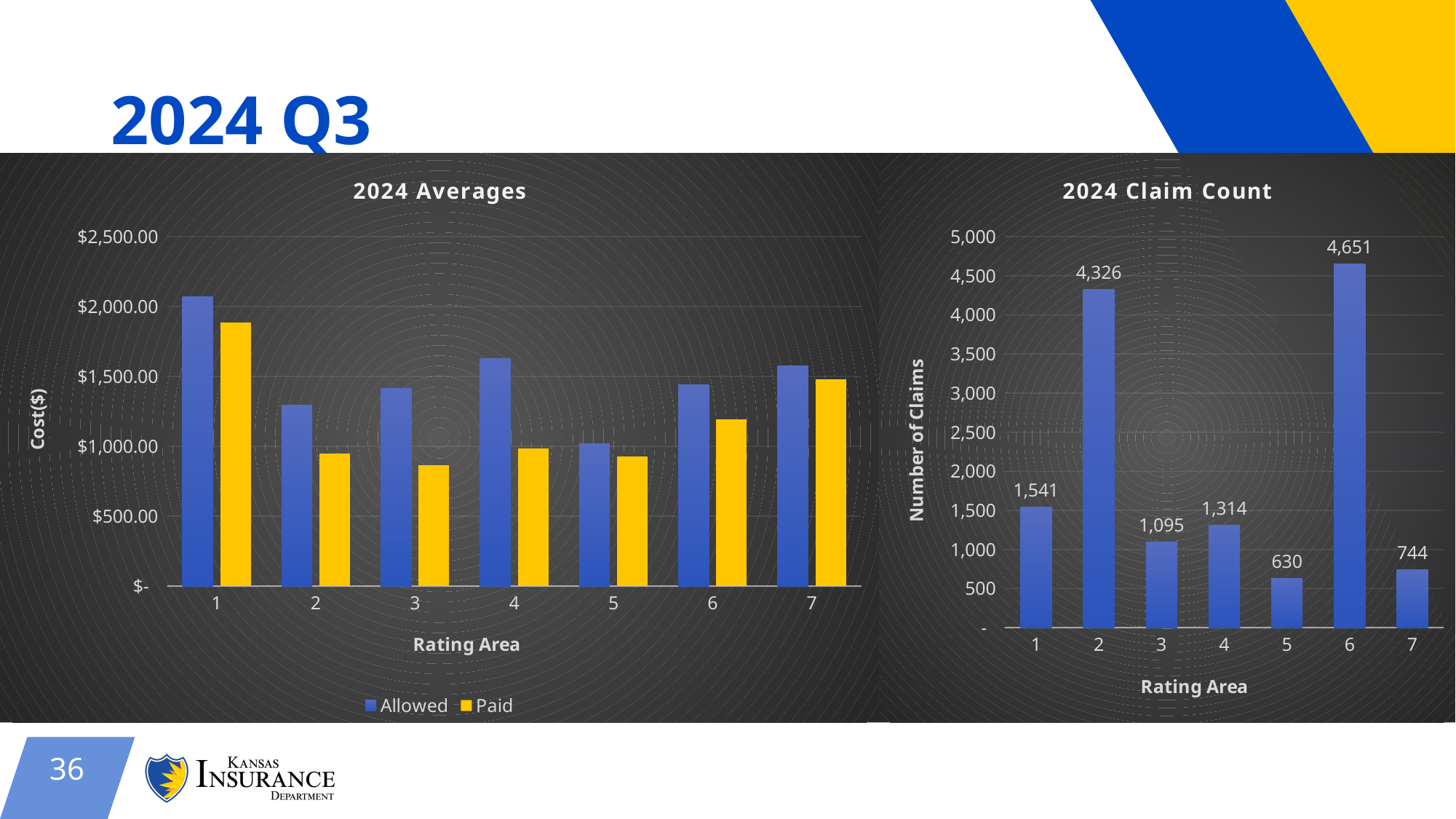
In the 2024 Claim Count chart, which rating area has the highest number of claims? 6 In the 2024 Claim Count chart, which rating area has the lowest number of claims? 5 In the 2024 Averages chart, how many series does the legend list? 2 In the 2024 Claim Count chart, which has more claims, rating area 1 or rating area 4? Rating area 1 In the 2024 Claim Count chart, what is the number of claims for rating area 3? 1,095 In the 2024 Averages chart, is the Allowed value for rating area 1 greater or less than $2,000.00? greater In the 2024 Claim Count chart, how many rating areas are shown on the x axis? 7 In the 2024 Claim Count chart, what is the difference in claims between rating area 6 and rating area 2? 325 In the 2024 Averages chart, is the Paid value for rating area 3 greater or less than $1,000.00? less In the 2024 Claim Count chart, how many claims are shown for rating area 6? 4,651 In the 2024 Averages chart, which rating area has the highest Allowed value? 1 What kind of chart is the 2024 Claim Count chart? Bar chart